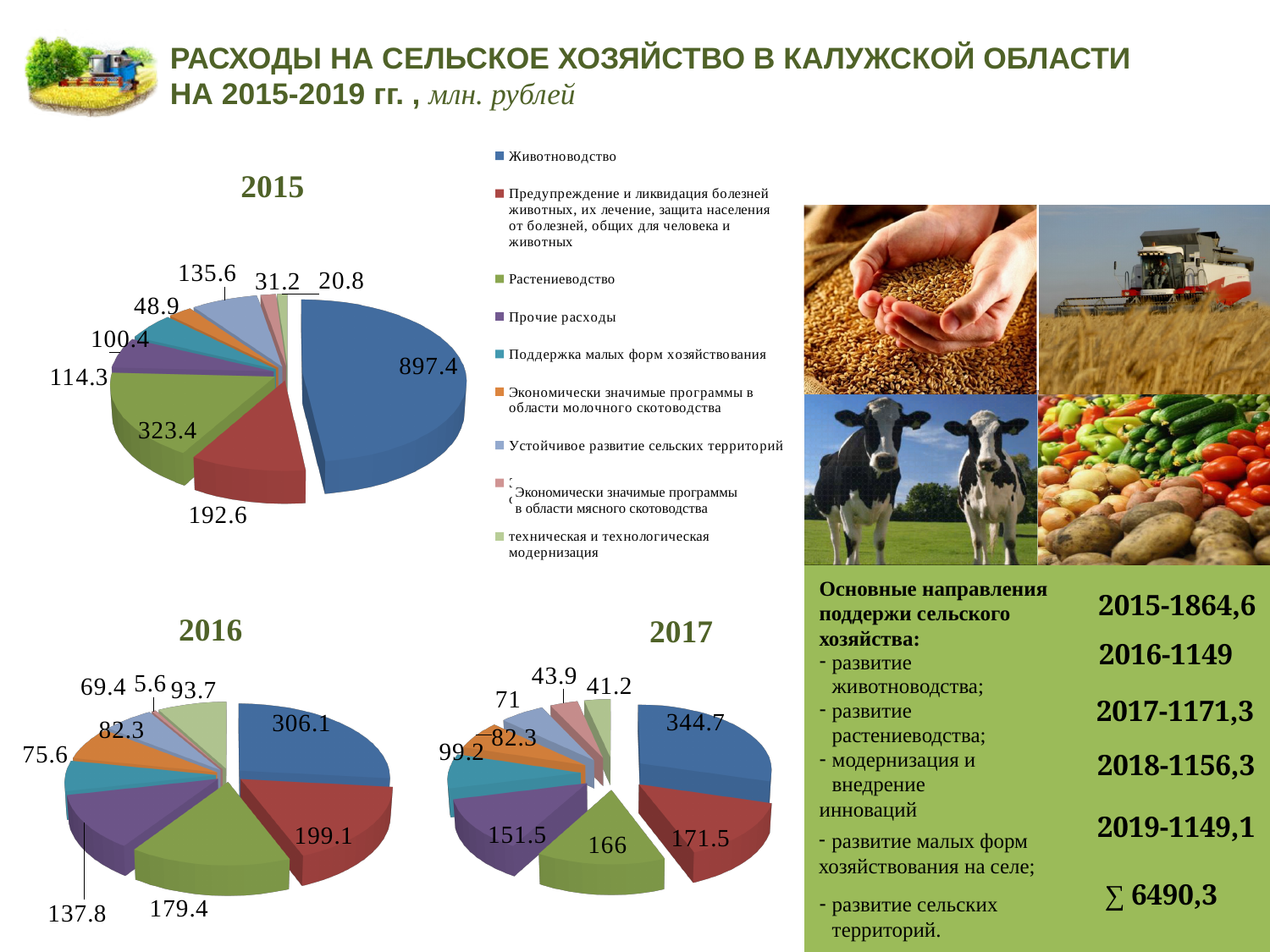
In the 2017 pie chart, what is the value for Животноводство? 344.7 What unit of measurement is stated in the slide title? млн. рублей In the 2015 pie chart, what is the value for Животноводство? 897.4 In the 2015 pie chart, which category has the smallest value? техническая и технологическая модернизация How many slices does the 2016 pie chart have? 9 In the 2017 pie chart, which is larger: Растениеводство or Прочие расходы? Растениеводство What kind of chart is used for the 2015 data? pie chart In the 2015 pie chart, which category has the largest value? Животноводство In the 2016 pie chart, what is the difference between Животноводство (306.1) and Предупреждение и ликвидация болезней животных (199.1)? 107 In the 2015 pie chart, what is the value for Растениеводство? 323.4 How many entries does the legend list? 9 In the 2016 pie chart, which category has the smallest value? Экономически значимые программы в области мясного скотоводства